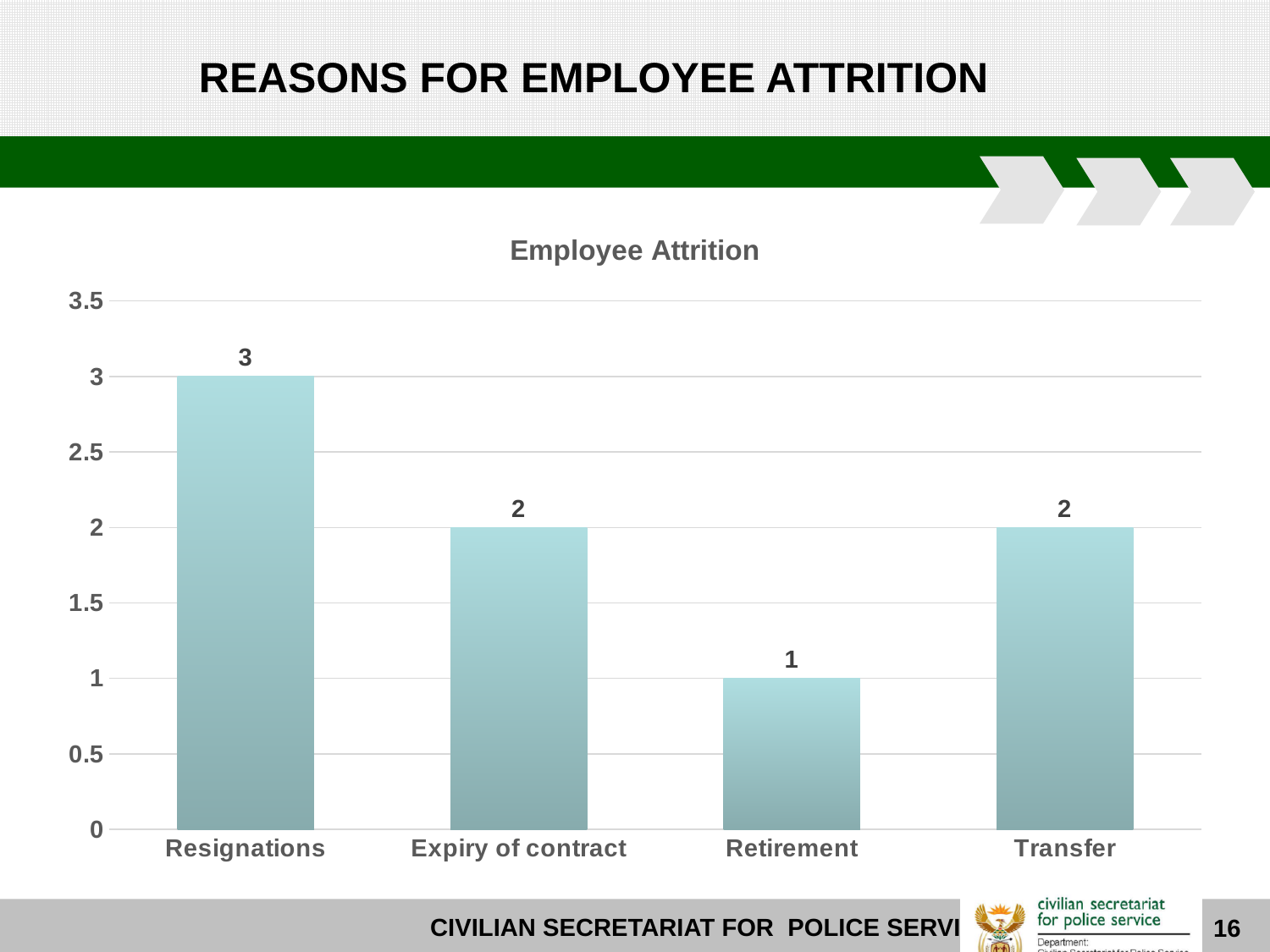
Which is larger, the value for Resignations or the value for Transfer? Resignations What is the value for Expiry of contract? 2 What is the value for Retirement? 1 How many categories are shown on the x axis? 4 Which category has the lowest value? Retirement What kind of chart is shown on the slide? bar chart Is the value for Resignations greater or less than 2.5? greater What is the difference between the values for Resignations and Retirement? 2 What is the title of the chart? Employee Attrition What is the value for Resignations? 3 Which category has the highest value? Resignations What is the value for Transfer? 2